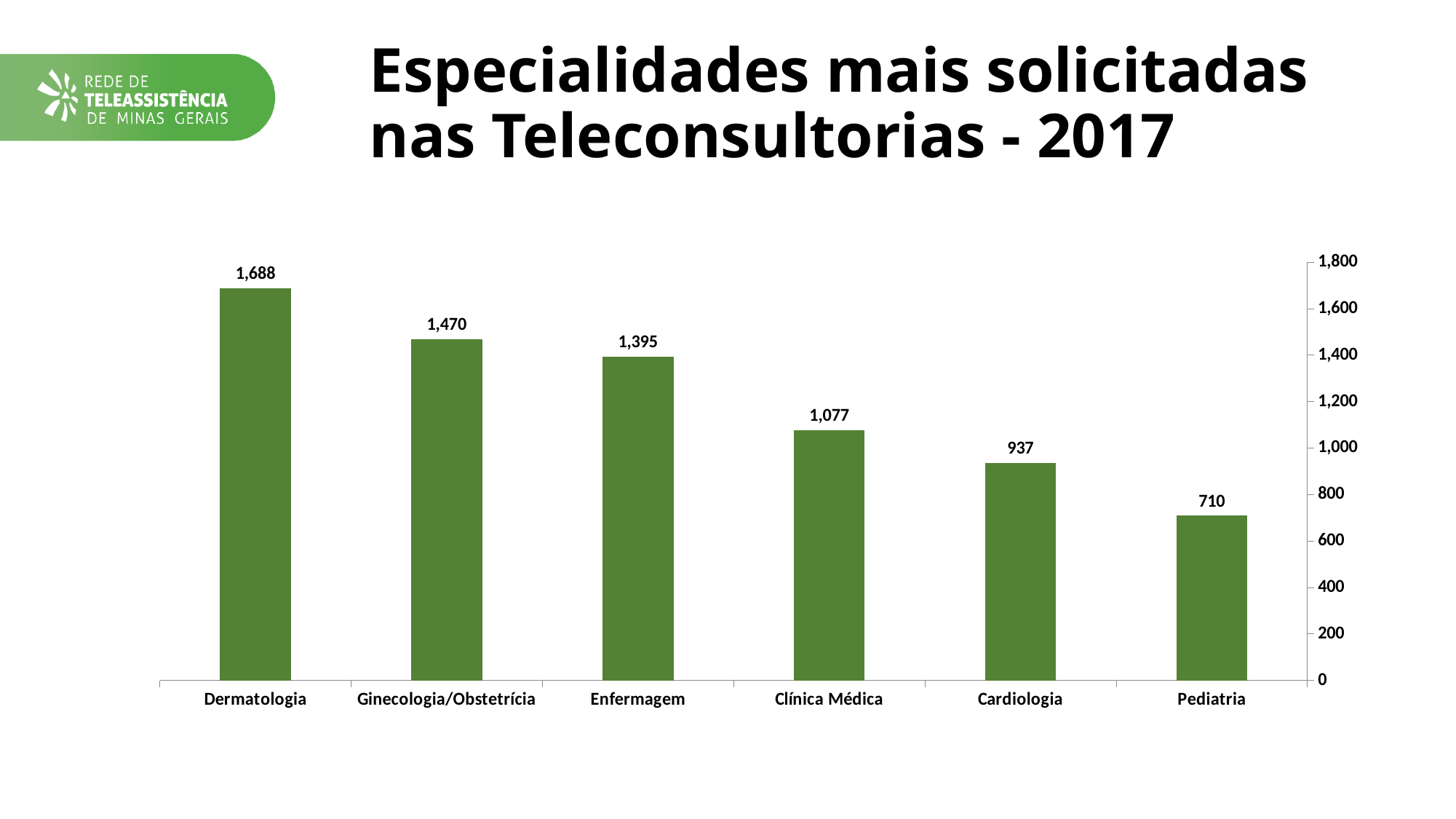
What kind of chart is shown on the slide? Bar chart What is the value for Enfermagem? 1,395 How many specialties are shown on the chart? 6 Which specialty has the highest value? Dermatologia What is the value for Cardiologia? 937 What is the value for Ginecologia/Obstetrícia? 1,470 Which is larger, the value for Enfermagem or the value for Clínica Médica? Enfermagem What is the difference between the values for Dermatologia and Pediatria? 978 What is the value for Pediatria? 710 What is the value for Dermatologia? 1,688 What is the value for Clínica Médica? 1,077 Which specialty has the lowest value? Pediatria